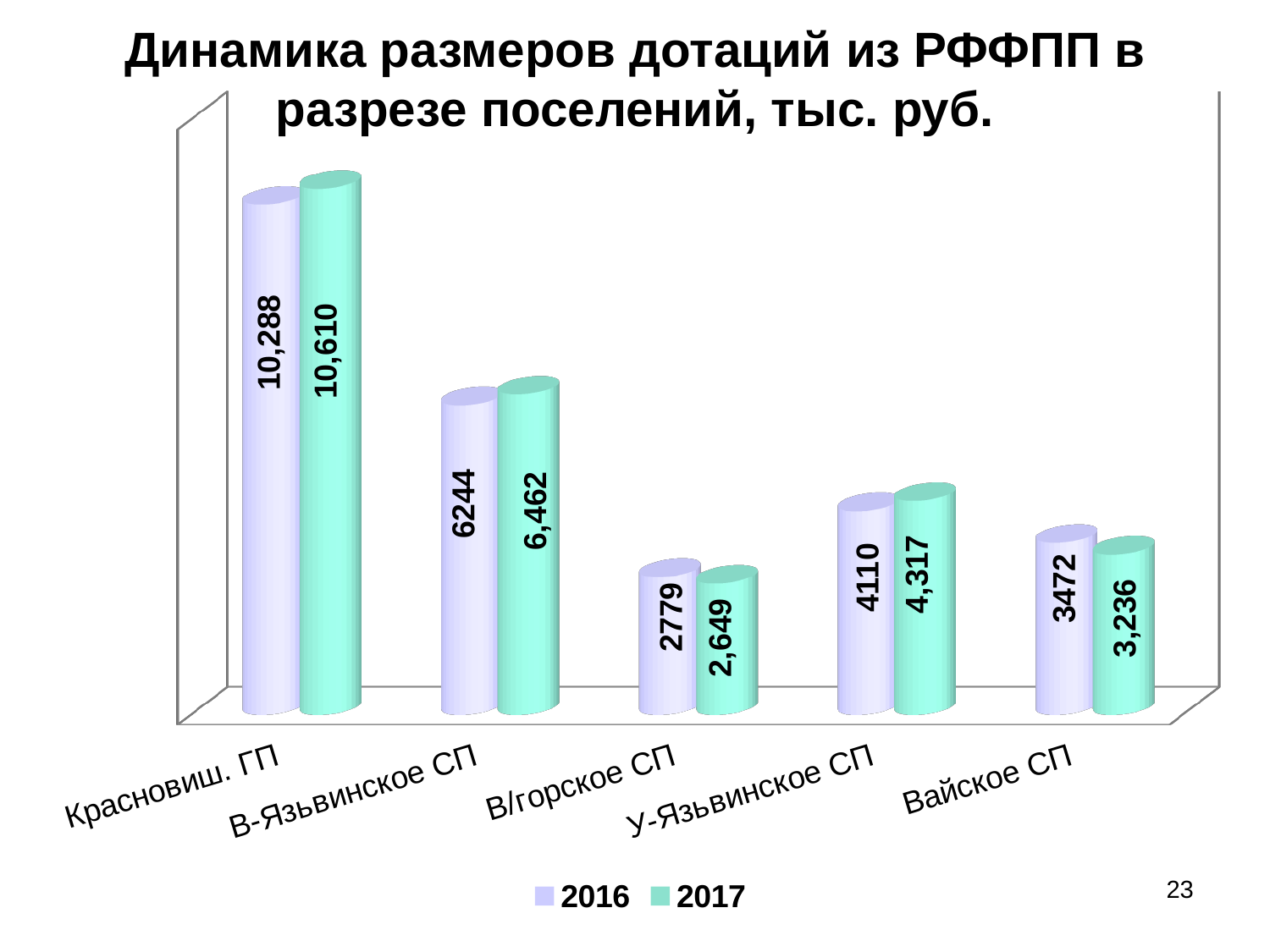
Which category has the lowest value in 2017? В/горское СП What kind of chart is shown on the slide? Bar chart How many categories are shown on the x axis? 5 What is the difference between the 2016 and 2017 values for Вайское СП? 236 How many series does the legend list? 2 What is the value for Вайское СП in 2017? 3,236 Which is larger for В-Язьвинское СП: the 2016 value or the 2017 value? 2017 What is the value for У-Язьвинское СП in 2016? 4110 What is the value for Красновиш. ГП in 2017? 10,610 What is the difference between the 2017 and 2016 values for Красновиш. ГП? 322 What is the value for В/горское СП in 2016? 2779 Which category has the highest value in 2016? Красновиш. ГП